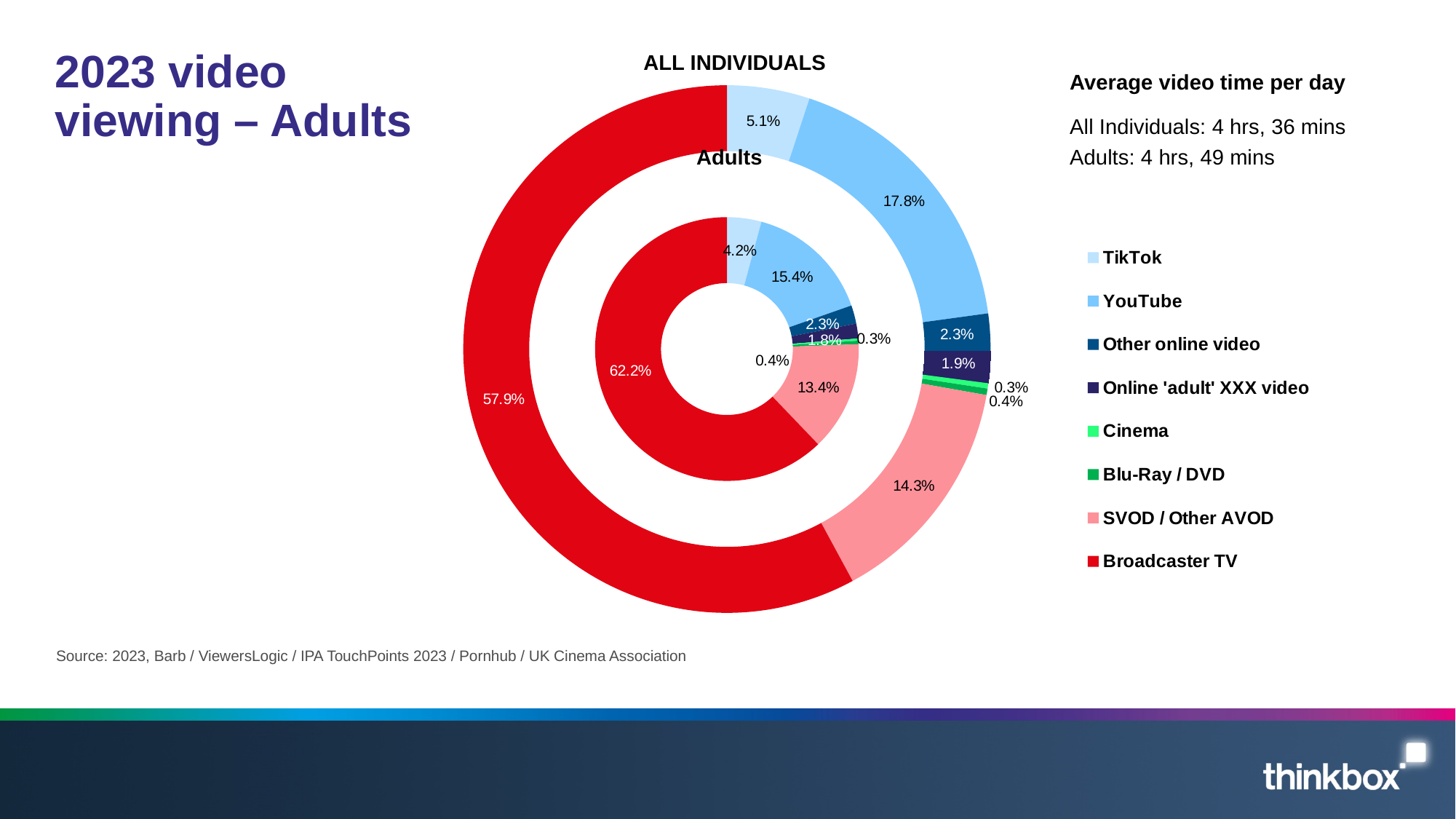
In the ALL INDIVIDUALS ring, what is the share for YouTube? 17.8% Is the YouTube share larger for All Individuals or for Adults? All Individuals What kind of chart is shown on the slide? Doughnut chart Which category has the smallest share in the ALL INDIVIDUALS ring? Cinema What is the difference between the Broadcaster TV share for Adults and for All Individuals? 4.3 percentage points Which colour represents Broadcaster TV in the chart? Red In the Adults ring, what share of video viewing is Broadcaster TV? 62.2% How many categories does the legend list? 8 In the Adults ring, what is the share for TikTok? 4.2% In the ALL INDIVIDUALS ring, what share of video viewing is Broadcaster TV? 57.9% Which category has the largest share in the ALL INDIVIDUALS ring? Broadcaster TV In the Adults ring, what is the share for SVOD / Other AVOD? 13.4%